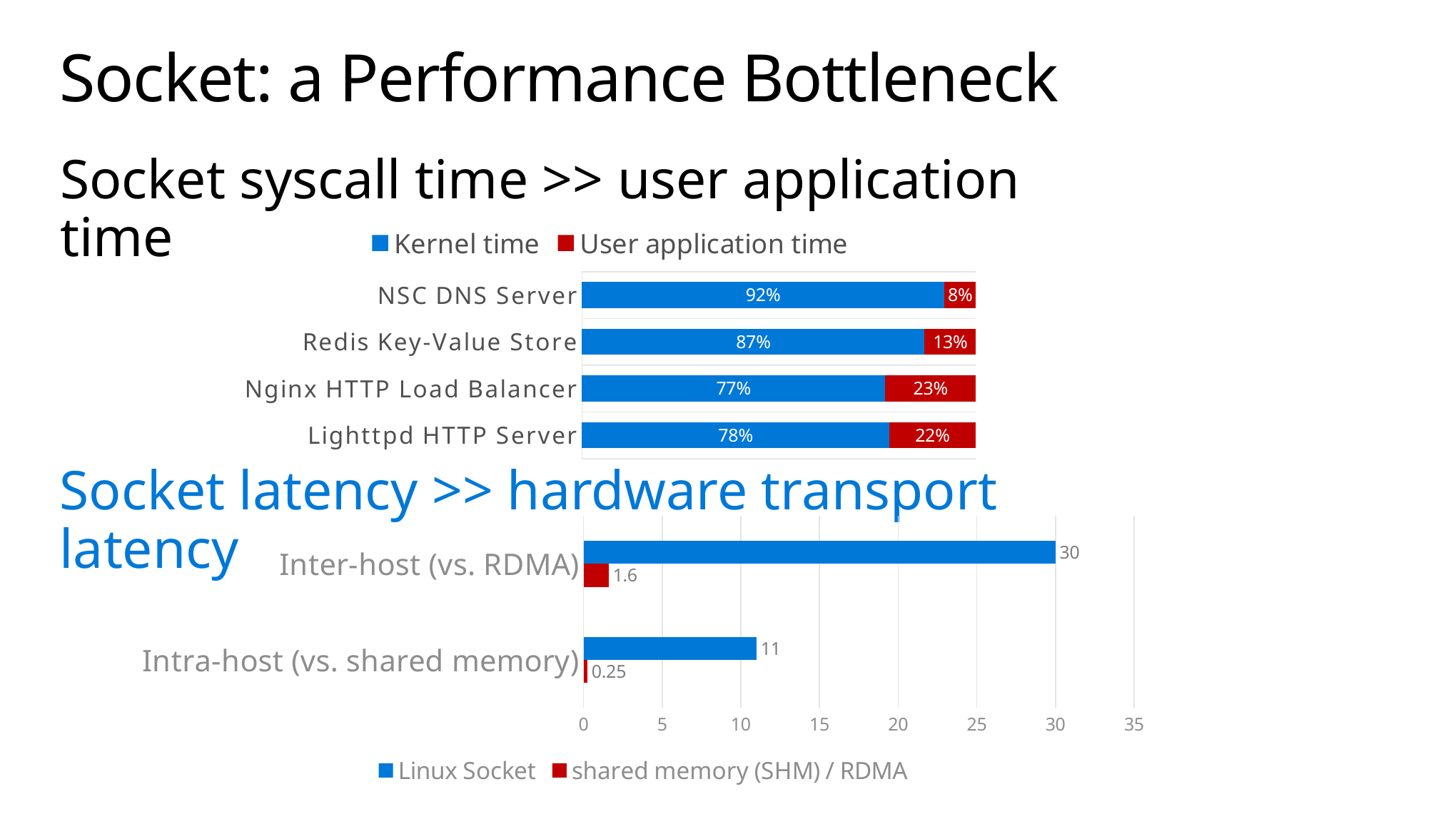
In the bottom chart (Linux Socket vs shared memory (SHM) / RDMA), which is larger: the Linux Socket value for Inter-host (vs. RDMA) or for Intra-host (vs. shared memory)? Inter-host (vs. RDMA) In the top chart (Kernel time vs User application time), what is the difference between the Kernel time of Redis Key-Value Store and Lighttpd HTTP Server? 9% In the top chart (Kernel time vs User application time), which category has the lowest User application time? NSC DNS Server In the top chart (Kernel time vs User application time), what is the Kernel time value for NSC DNS Server? 92% In the bottom chart (Linux Socket vs shared memory (SHM) / RDMA), what is the shared memory (SHM) / RDMA value for Intra-host (vs. shared memory)? 0.25 In the top chart (Kernel time vs User application time), how many categories are shown? 4 In the bottom chart (Linux Socket vs shared memory (SHM) / RDMA), how many series does the legend list? 2 In the bottom chart (Linux Socket vs shared memory (SHM) / RDMA), what is the Linux Socket value for Inter-host (vs. RDMA)? 30 In the bottom chart (Linux Socket vs shared memory (SHM) / RDMA), what is the difference between the Linux Socket value and the shared memory (SHM) / RDMA value for Inter-host (vs. RDMA)? 28.4 In the top chart (Kernel time vs User application time), what kind of chart is it? Stacked bar chart In the top chart (Kernel time vs User application time), which category has the highest Kernel time? NSC DNS Server In the top chart (Kernel time vs User application time), what is the User application time value for Nginx HTTP Load Balancer? 23%